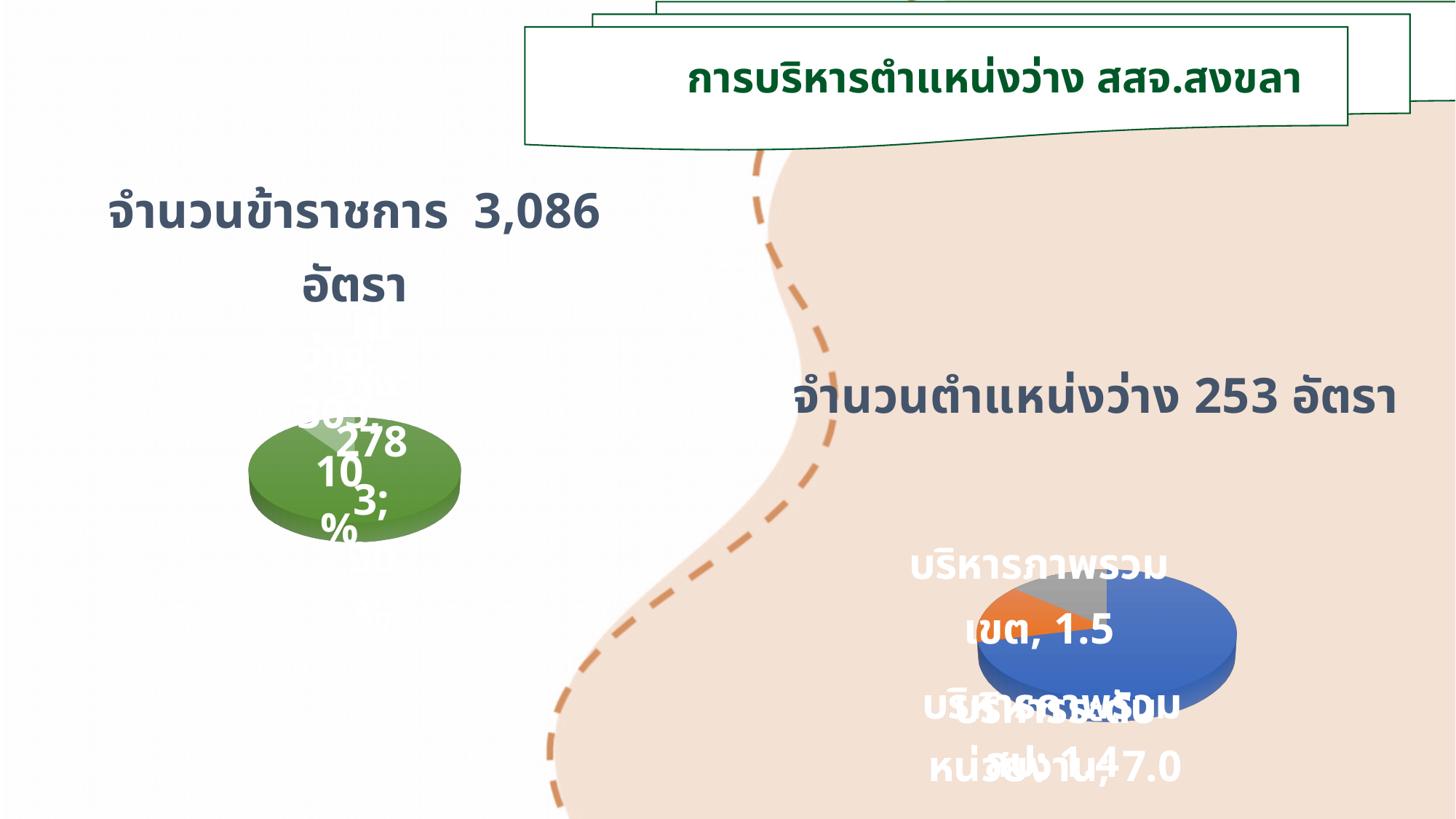
What kind of chart is the green chart on the left side of the slide? pie chart In the pie chart on the right side of the slide, which colour slice is the largest? blue What colour is the pie chart on the left side of the slide? green In the pie chart on the right side of the slide, what value is shown for บริหารภาพรวมเขต? 1.5 What is the title shown at the top of the slide? การบริหารตำแหน่งว่าง สสจ.สงขลา What kind of chart is the chart on the right side of the slide? pie chart How many slices does the pie chart on the right side of the slide have? 3